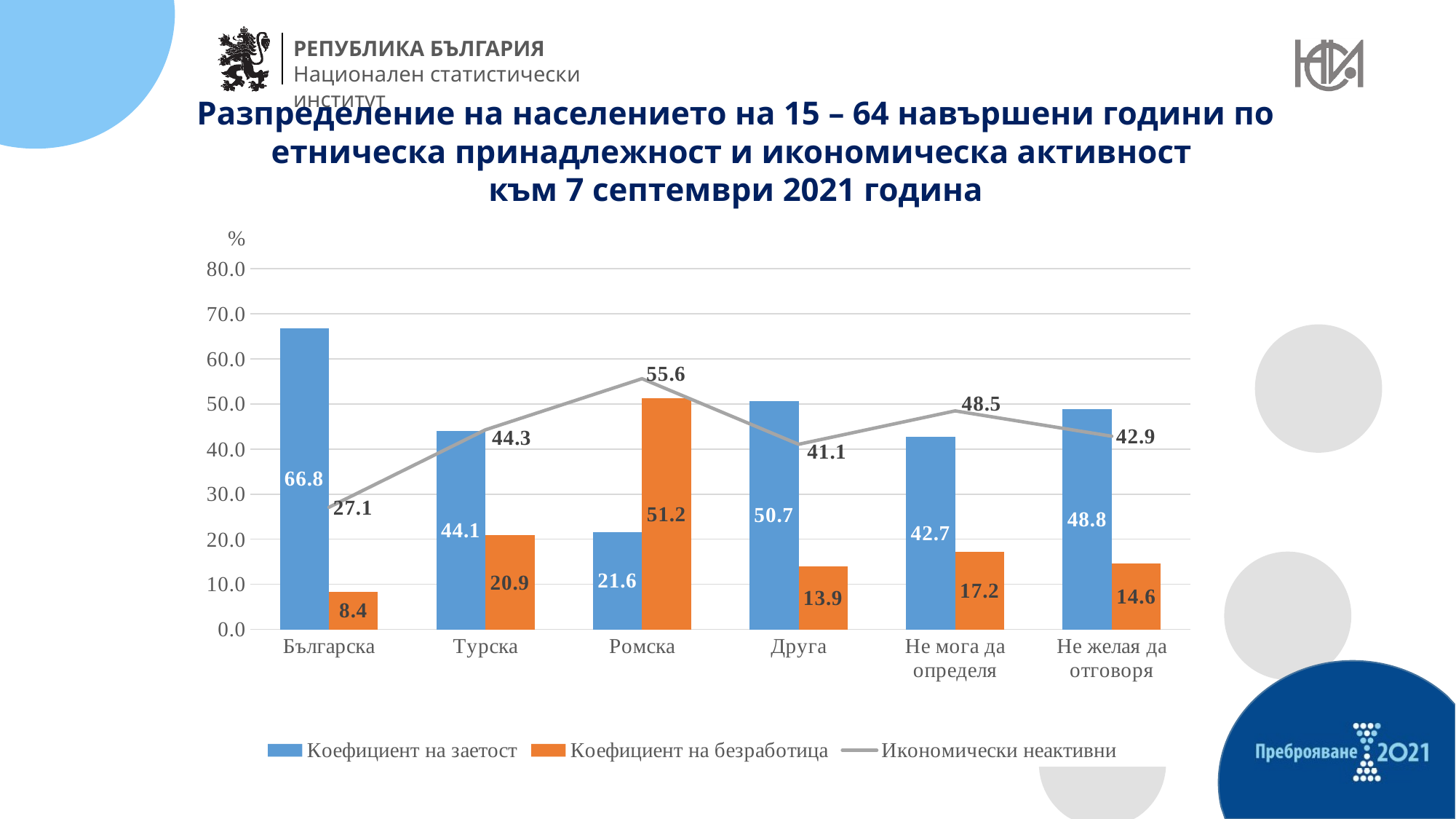
What is the value of Икономически неактивни for Не мога да определя? 48.5 What is the difference between Коефициент на заетост and Коефициент на безработица for Турска? 23.2 Which category has the highest Коефициент на заетост? Българска What kind of chart is shown on the slide? Combined bar and line chart How many series does the legend list? 3 Which category has the highest value for Икономически неактивни? Ромска Which is larger for Друга: Коефициент на заетост or Икономически неактивни? Коефициент на заетост Which category has the lowest Коефициент на безработица? Българска What colour are the bars for Коефициент на безработица? Orange What is the value of Коефициент на заетост for Българска? 66.8 How many categories are shown on the x axis? 6 What is the value of Коефициент на безработица for Ромска? 51.2